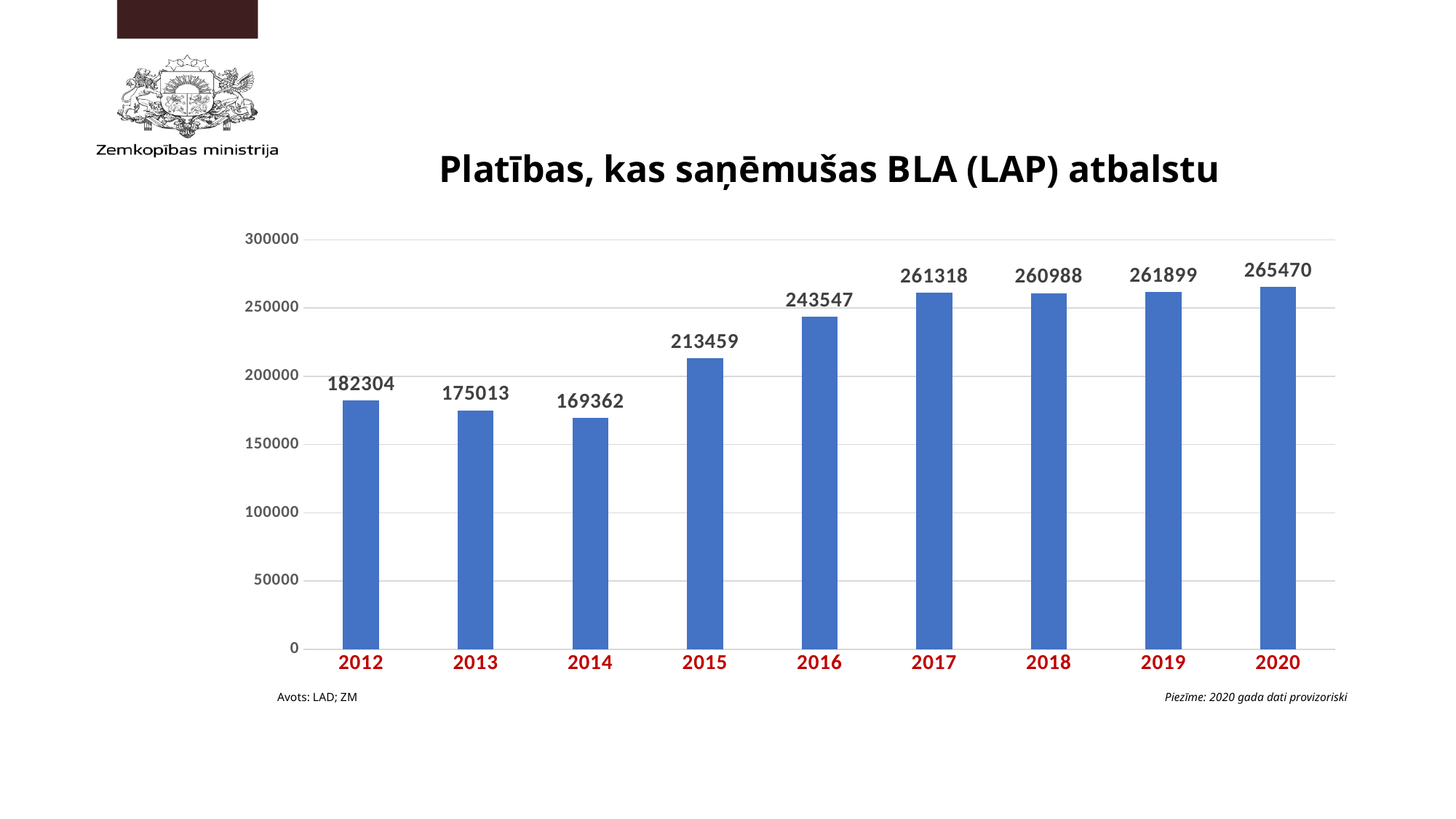
Which year has the highest value? 2020 Which is larger, the value for 2015 or the value for 2016? 2016 How many years are shown on the x axis? 9 What is the value for 2020? 265470 Is the value for 2014 greater or less than 200000? less Which year has the lowest value? 2014 What is the value for 2012? 182304 What is the title of the chart? Platības, kas saņēmušas BLA (LAP) atbalstu What is the difference between the values for 2020 and 2012? 83166 What is the difference between the values for 2016 and 2015? 30088 What kind of chart is shown on the slide? bar chart What is the value for 2016? 243547